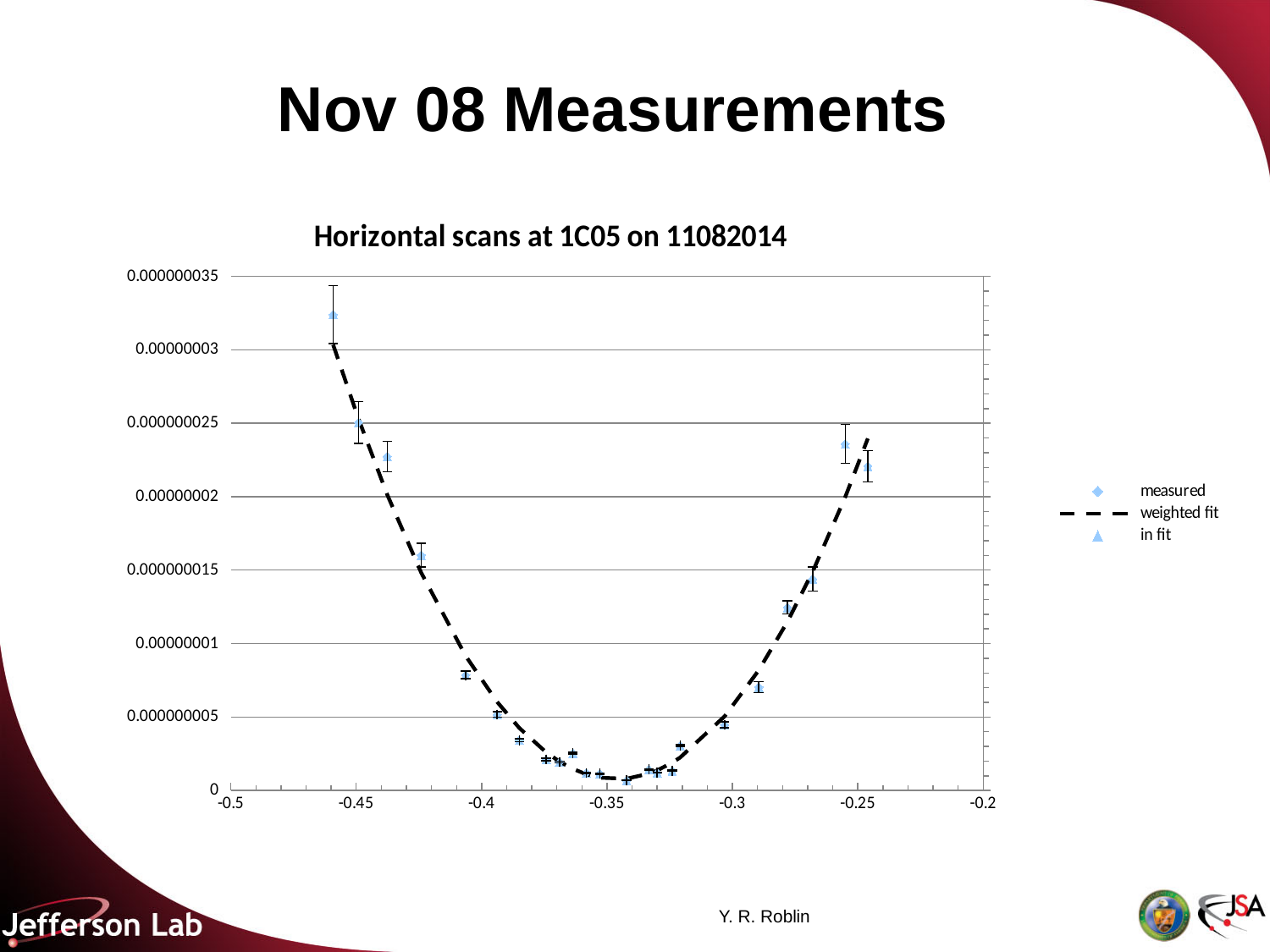
Which legend entry is drawn as a dashed line? weighted fit What kind of chart is shown on the slide? Scatter chart with a fitted curve Is the measured value at x = -0.3 greater or less than 0.00000001? less What is the highest value labelled on the y axis? 0.000000035 Is the measured value at x = -0.45 greater or less than 0.00000002? greater Which is larger: the measured value near x = -0.46 or the measured value near x = -0.25? near x = -0.46 How many series does the chart legend list? 3 Do the measured values rise or fall as x goes from -0.45 to -0.35? fall Is the measured value at x = -0.25 greater or less than 0.00000002? greater What is the title of the chart? Horizontal scans at 1C05 on 11082014 Do the measured values rise or fall as x goes from -0.35 to -0.25? rise